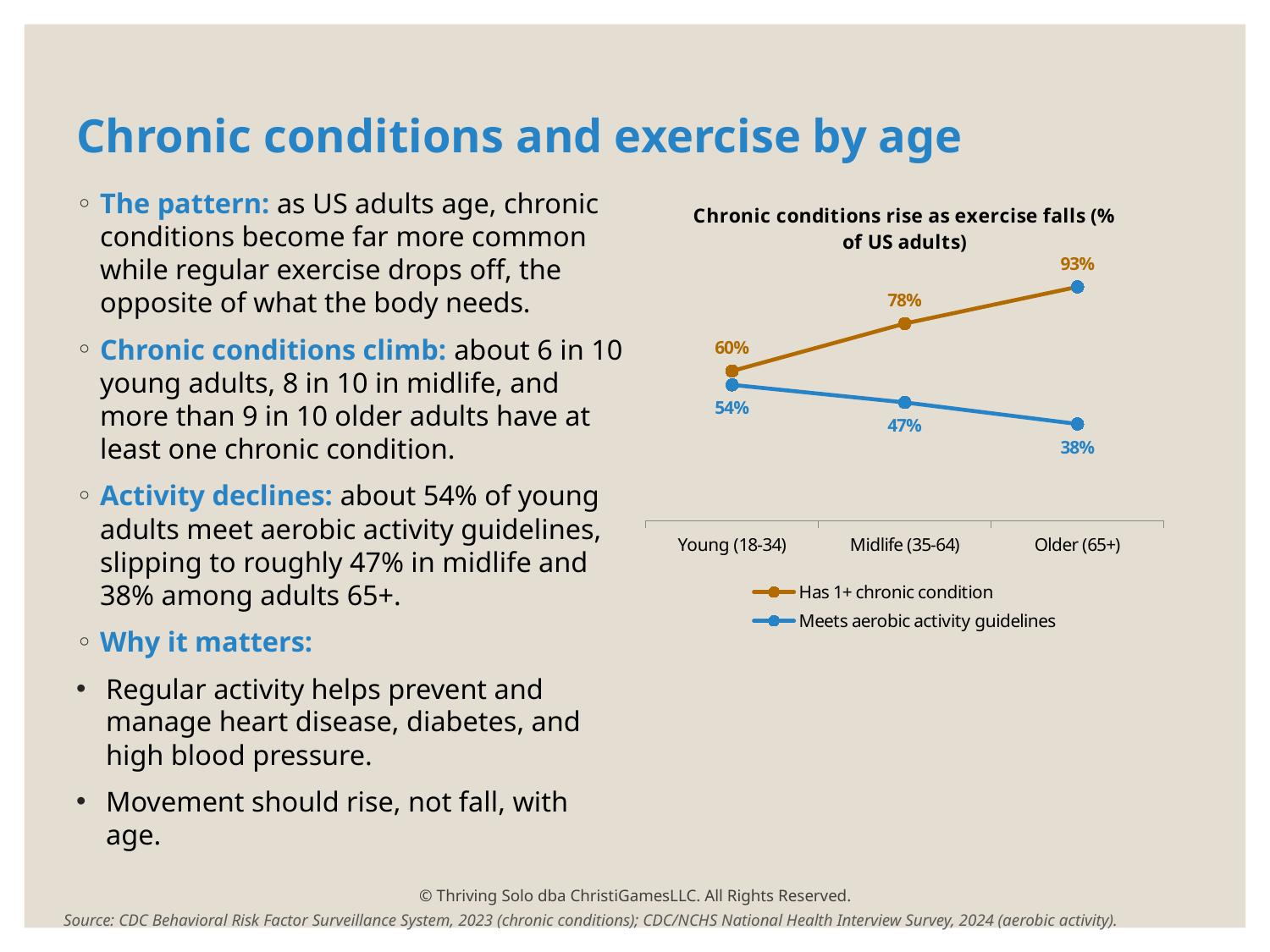
What percentage of Older (65+) adults meet aerobic activity guidelines? 38% Does the 'Meets aerobic activity guidelines' series rise or fall across the age groups from left to right? Fall Which age group has the lowest share meeting aerobic activity guidelines? Older (65+) How many age groups are shown on the x axis? 3 Which age group has the highest share with 1+ chronic condition? Older (65+) By how many percentage points does the 'Meets aerobic activity guidelines' value fall from Young (18-34) to Older (65+)? 16% What is the difference between the 'Has 1+ chronic condition' and 'Meets aerobic activity guidelines' values for Older (65+)? 55% How many series does the legend list? 2 Which is larger for Midlife (35-64): the share with 1+ chronic condition or the share meeting aerobic activity guidelines? Has 1+ chronic condition What is the value for Midlife (35-64) in the 'Has 1+ chronic condition' series? 78% What percentage of Young (18-34) adults have 1+ chronic condition? 60% What kind of chart is shown on the slide? Line chart